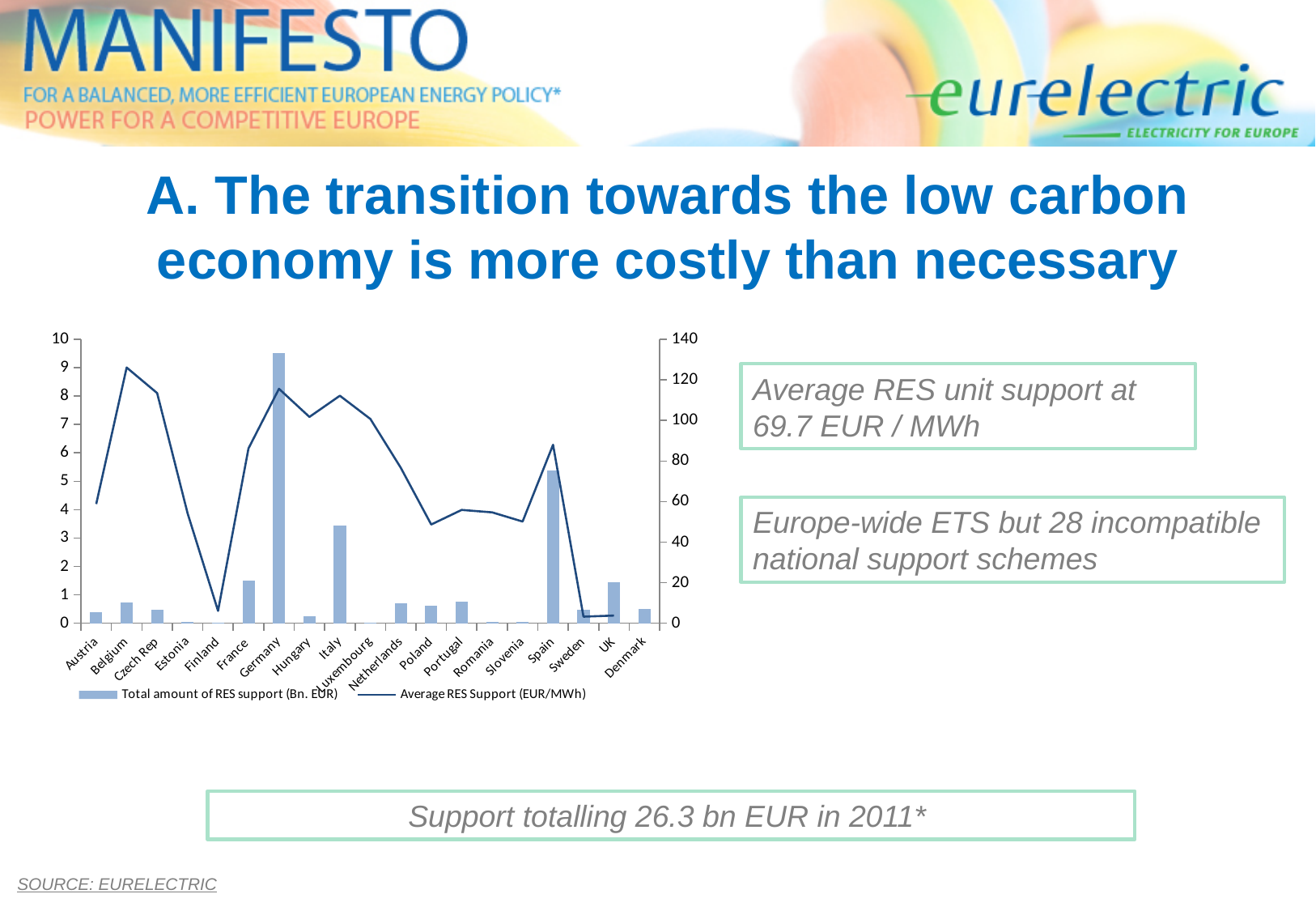
Is the Total amount of RES support bar for Germany greater or less than 9? greater What is the name of the series plotted as bars in the chart? Total amount of RES support (Bn. EUR) Is the Total amount of RES support bar for Spain greater or less than 5? greater What kind of chart is shown on the slide? A combined bar and line chart Which has the larger Total amount of RES support bar, Germany or Spain? Germany Is the Average RES Support (EUR/MWh) value for Finland greater or less than 20? less How many countries are shown on the x axis of the chart? 19 Which country has the highest value on the Average RES Support (EUR/MWh) line? Belgium How many series does the chart legend list? 2 Which country has the highest bar for Total amount of RES support (Bn. EUR)? Germany